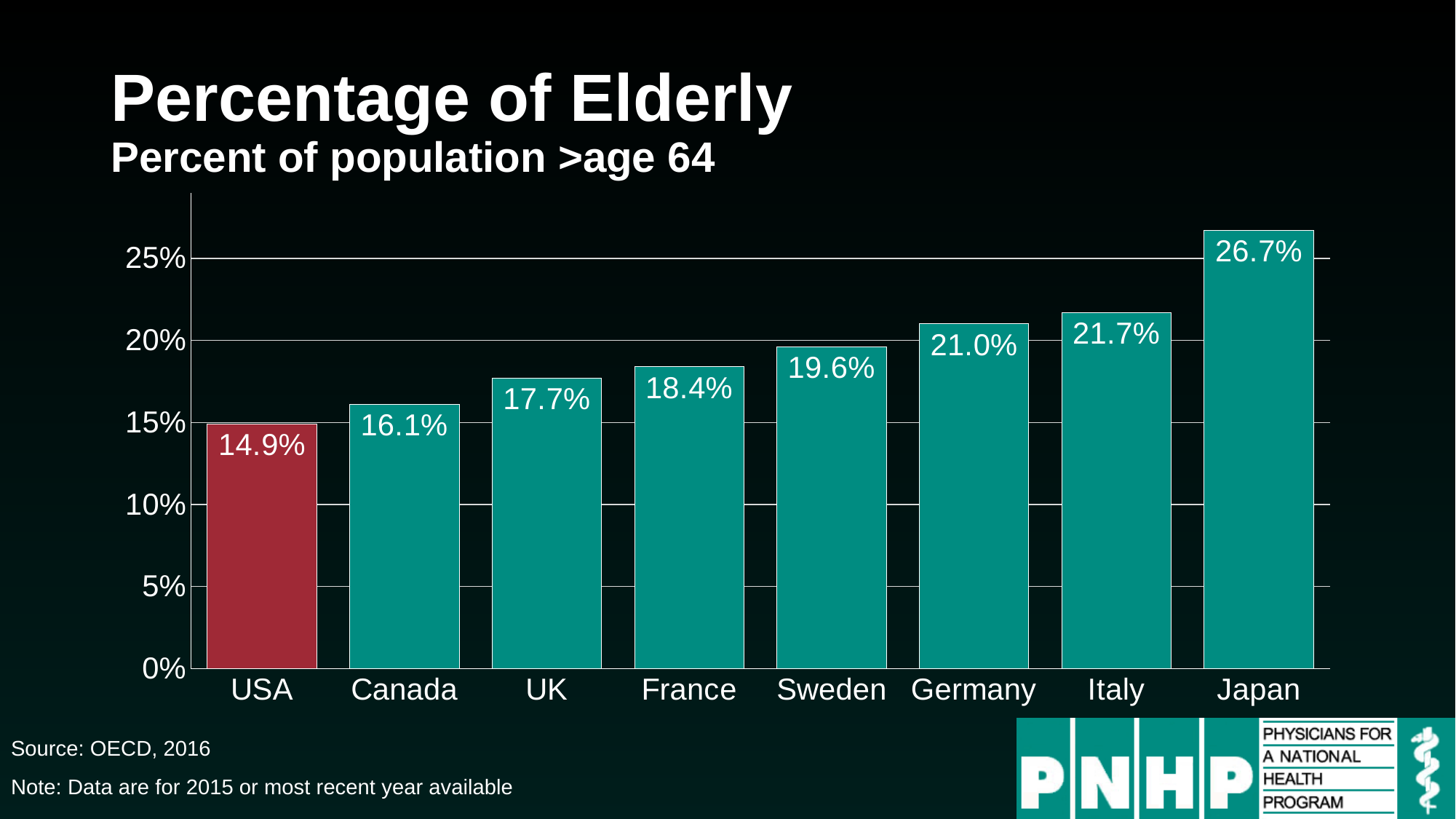
Which country has the lowest percentage of elderly? USA What is the difference between Italy's value and Canada's value? 5.6% Which bar is shown in a different colour (red) from the others? USA What is the value shown for Germany? 21.0% What kind of chart is shown on the slide? Bar chart How many countries are shown in the chart? 8 Is the value for Italy greater or less than 20%? greater What is the value shown for Sweden? 19.6% What is the difference between Japan's value and the USA's value? 11.8% What is the percentage of population over age 64 for the USA? 14.9% Which country has the highest percentage of elderly? Japan Which has a higher percentage of elderly, France or the UK? France